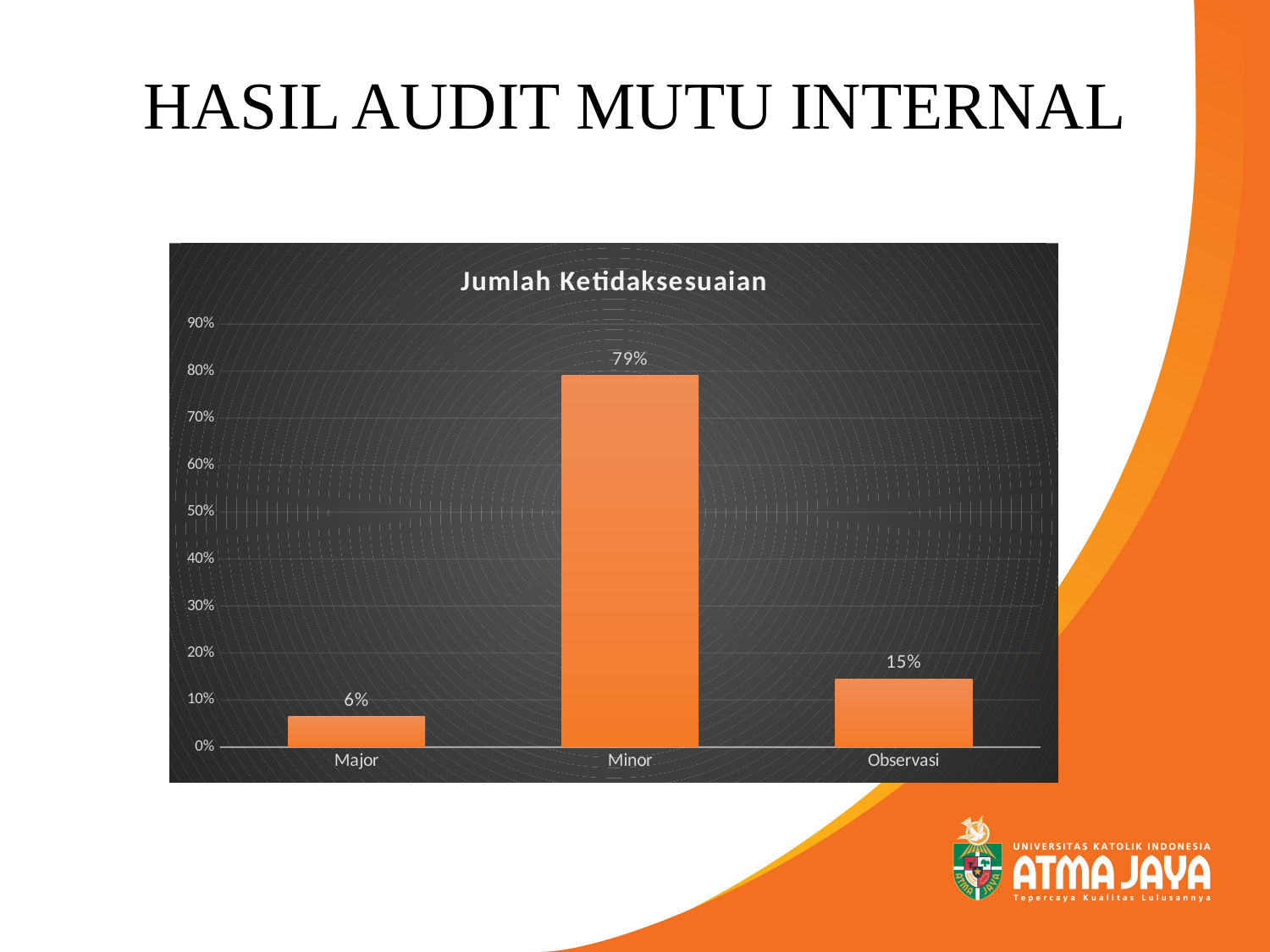
How many categories are shown on the x axis? 3 Which category has the lowest value? Major What is the difference between the values for Observasi and Major? 9% What kind of chart is shown on the slide? bar chart Which is larger, the value for Observasi or the value for Major? Observasi What is the value for Observasi? 15% What is the value for Minor? 79% What is the value for Major? 6% Is the value for Minor greater or less than 50%? greater What is the title of the chart? Jumlah Ketidaksesuaian Which category has the highest value? Minor What is the difference between the values for Minor and Observasi? 64%